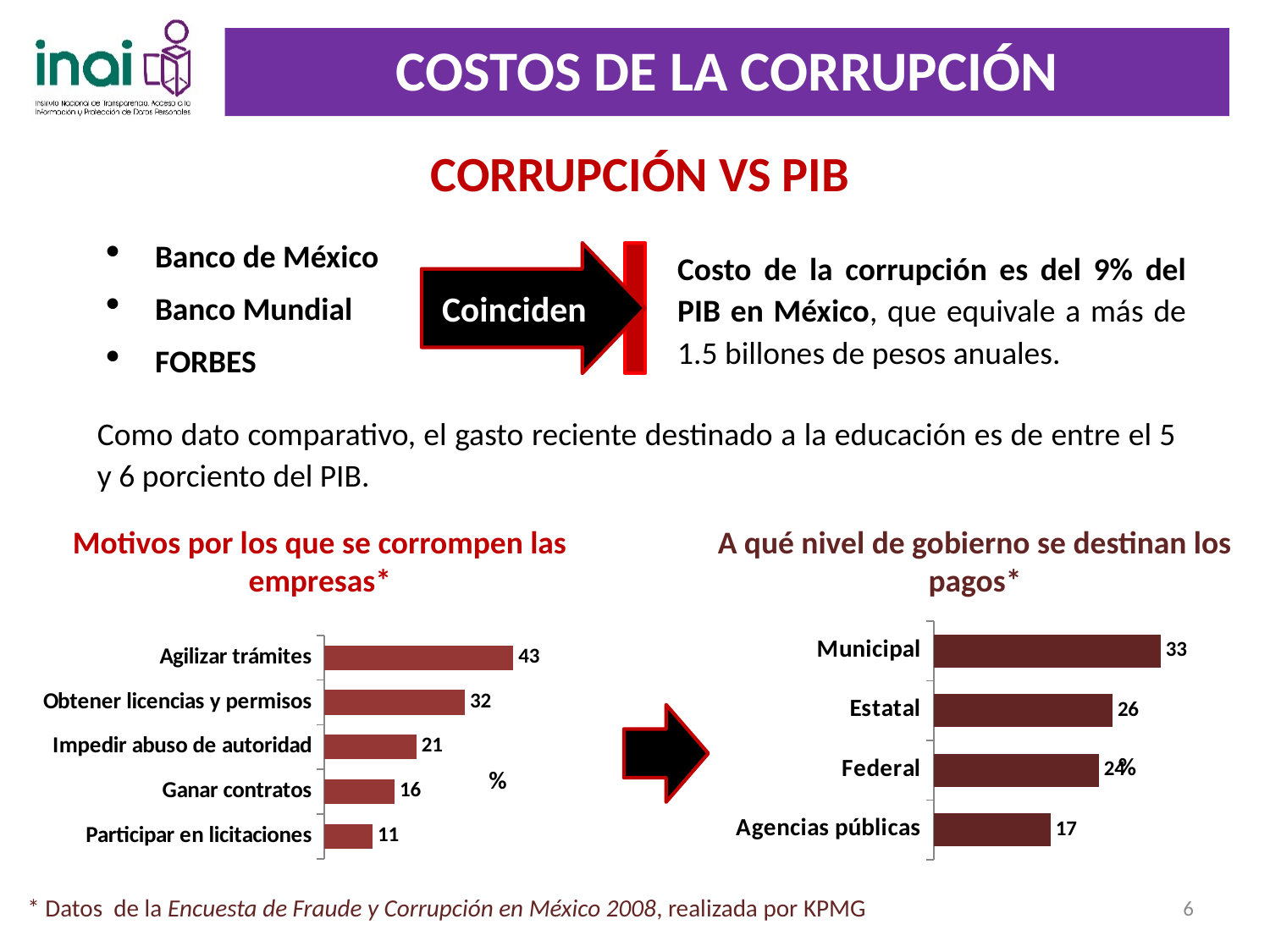
In the chart 'Motivos por los que se corrompen las empresas', what is the difference between Obtener licencias y permisos and Impedir abuso de autoridad? 11 In the chart 'A qué nivel de gobierno se destinan los pagos', which is larger, Estatal or Agencias públicas? Estatal In the chart 'Motivos por los que se corrompen las empresas', what is the value for Ganar contratos? 16 In the chart 'A qué nivel de gobierno se destinan los pagos', which level has the highest value? Municipal In the chart 'Motivos por los que se corrompen las empresas', which category has the highest value? Agilizar trámites In the chart 'Motivos por los que se corrompen las empresas', how many categories are shown? 5 In the chart 'A qué nivel de gobierno se destinan los pagos', what is the difference between Municipal and Estatal? 7 In the chart 'Motivos por los que se corrompen las empresas', which category has the lowest value? Participar en licitaciones In the chart 'A qué nivel de gobierno se destinan los pagos', what is the value for Agencias públicas? 17 In the chart 'A qué nivel de gobierno se destinan los pagos', what is the value for Municipal? 33 In the chart 'Motivos por los que se corrompen las empresas', what is the value for Agilizar trámites? 43 What type of chart is 'A qué nivel de gobierno se destinan los pagos'? Bar chart